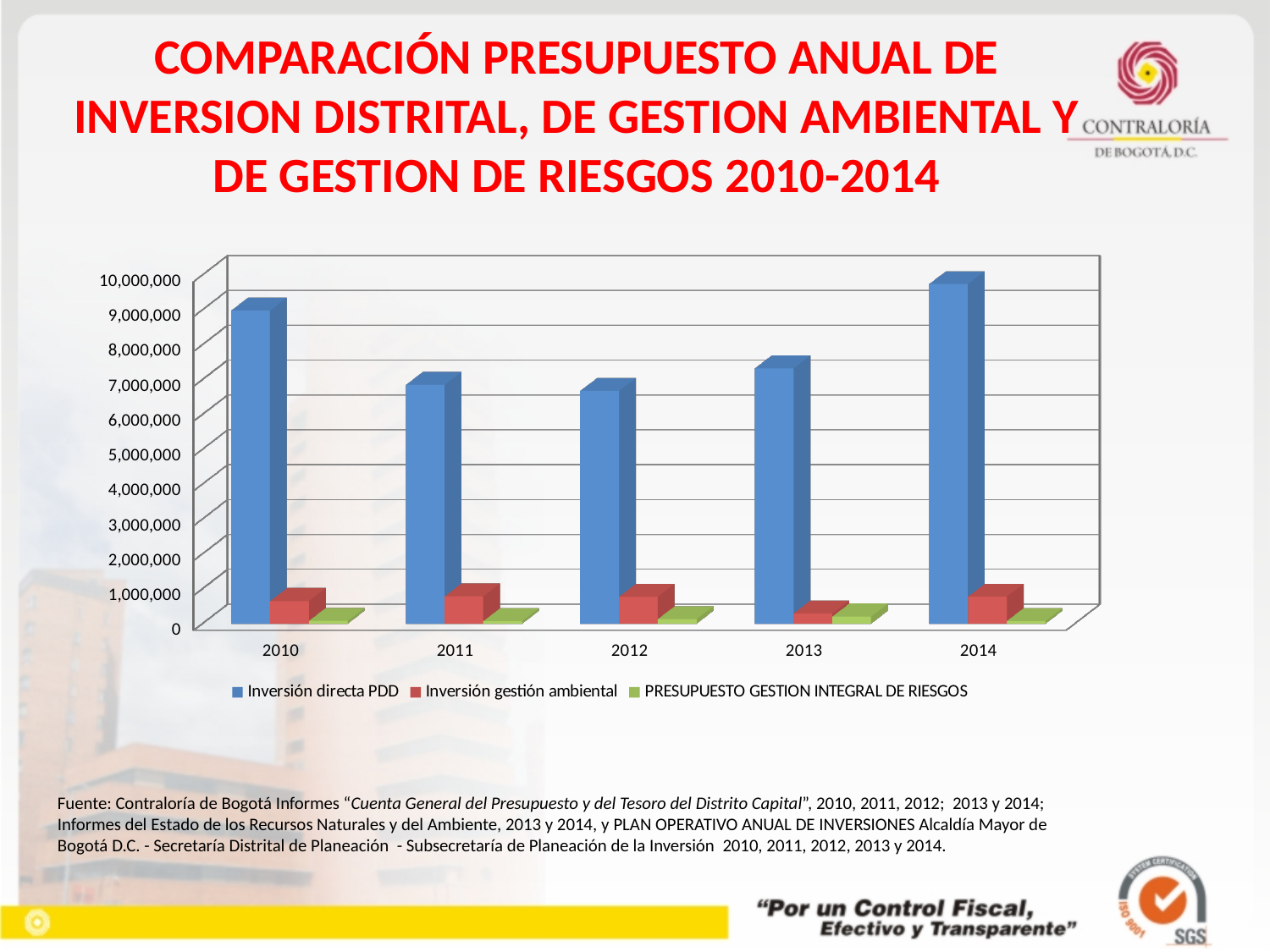
How many years are shown on the x axis of the chart? 5 Which series is shown in blue in the chart? Inversión directa PDD What kind of chart is shown on the slide? bar chart Is the Inversión directa PDD value for 2011 greater or less than 8,000,000? less Is the Inversión gestión ambiental value for 2010 greater or less than 1,000,000? less Which year has the larger Inversión directa PDD value, 2010 or 2011? 2010 Is the Inversión directa PDD value for 2014 greater or less than 9,000,000? greater In which year is the Inversión gestión ambiental bar the lowest? 2013 In which year is the Inversión directa PDD bar the highest? 2014 Which series is shown in green in the chart? PRESUPUESTO GESTION INTEGRAL DE RIESGOS How many series does the chart legend list? 3